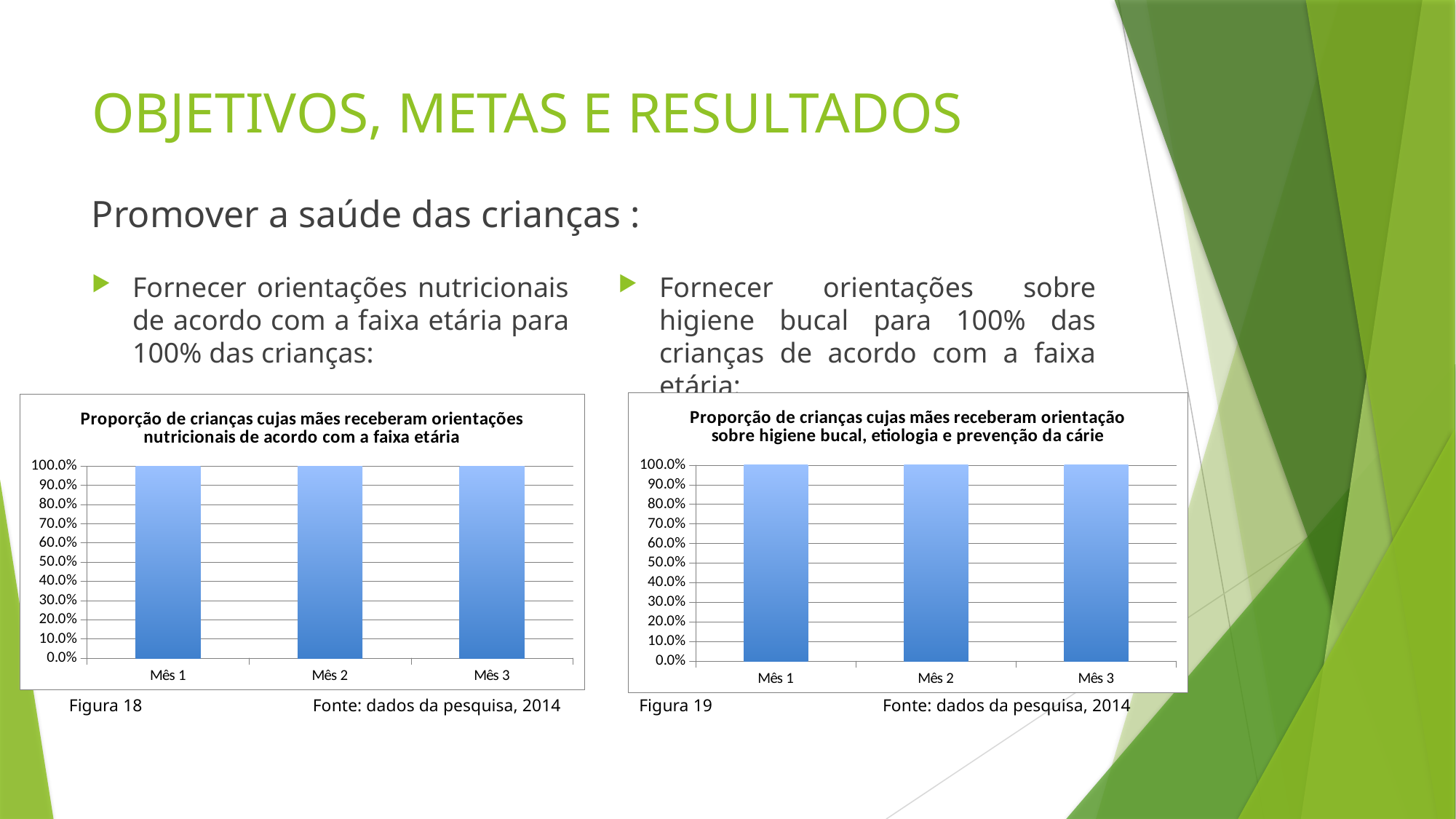
What kind of chart is the left chart (Figura 18)? Bar chart How many categories are shown on the x axis of the left chart (Figura 18)? 3 In the left chart (Figura 18), what is the difference between the values for Mês 1 and Mês 2? 0.0% In the right chart (Figura 19), what is the value for Mês 3? 100.0% In the left chart (Figura 18), what is the value for Mês 3? 100.0% How many bars are plotted in the right chart (Figura 19)? 3 In the right chart (Figura 19), is the value for Mês 1 greater or less than 50.0%? greater In the left chart (Figura 18), what is the value for Mês 1? 100.0% What is the title of the right chart (Figura 19)? Proporção de crianças cujas mães receberam orientação sobre higiene bucal, etiologia e prevenção da cárie In the left chart (Figura 18), do the values rise, fall or stay the same from Mês 1 to Mês 3? Stay the same In the right chart (Figura 19), what is the value for Mês 2? 100.0% What kind of chart is the right chart (Figura 19)? Bar chart